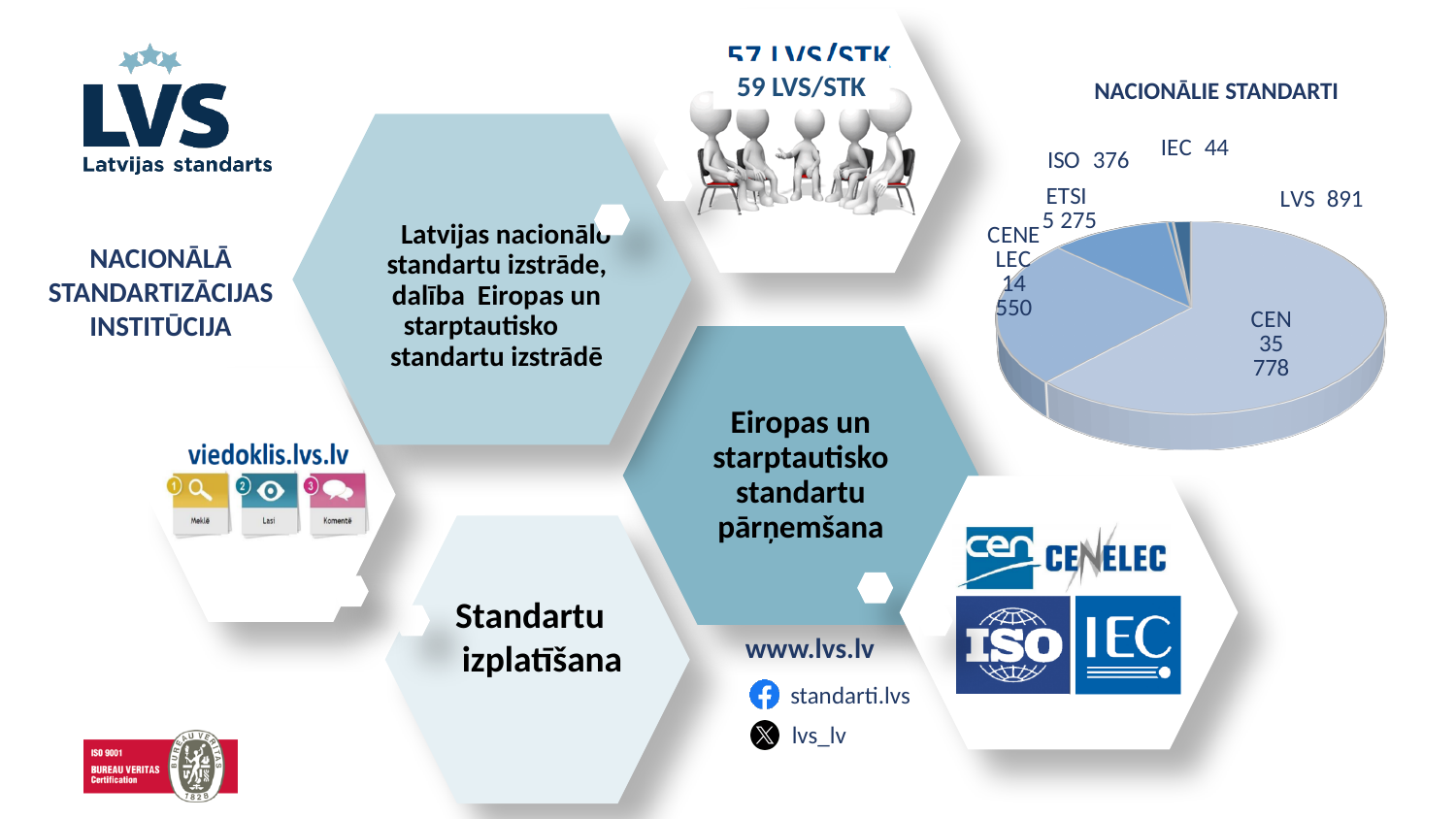
In the NACIONĀLIE STANDARTI pie chart, which is larger, the value for LVS or the value for ISO? LVS What type of chart is shown under the title NACIONĀLIE STANDARTI? pie chart What is the title of the pie chart on the slide? NACIONĀLIE STANDARTI Which category has the smallest value in the NACIONĀLIE STANDARTI pie chart? IEC Which category has the largest slice in the NACIONĀLIE STANDARTI pie chart? CEN In the NACIONĀLIE STANDARTI pie chart, what is the value for CEN? 35 778 In the NACIONĀLIE STANDARTI pie chart, what is the value for ETSI? 5 275 How many slices does the NACIONĀLIE STANDARTI pie chart have? 6 In the NACIONĀLIE STANDARTI pie chart, what is the difference between the CEN and CENELEC values? 21 228 In the NACIONĀLIE STANDARTI pie chart, what is the value for ISO? 376 In the NACIONĀLIE STANDARTI pie chart, what is the value for LVS? 891 In the NACIONĀLIE STANDARTI pie chart, what is the value for CENELEC? 14 550